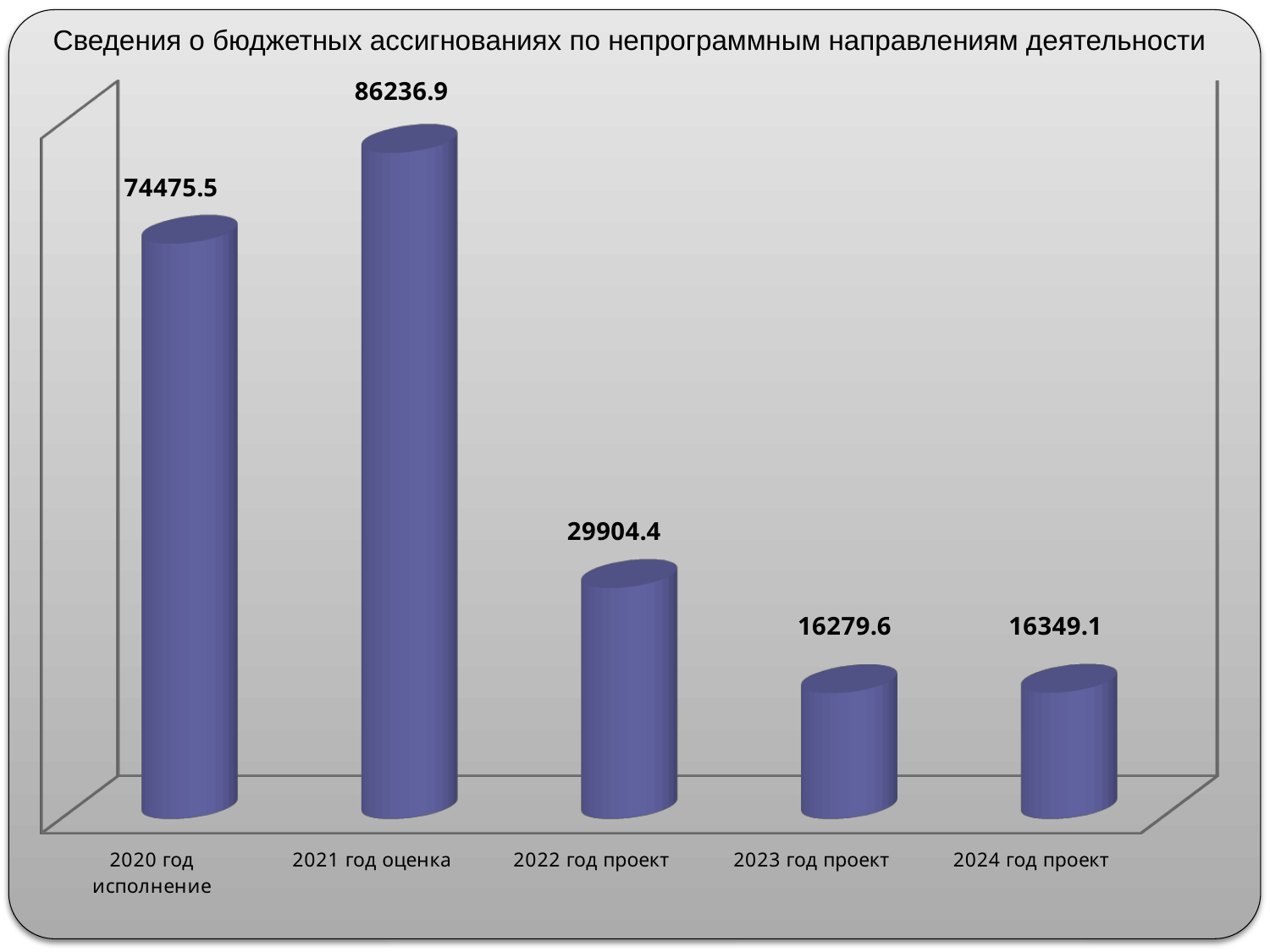
How many categories are shown on the x axis? 5 What is the title of the chart? Сведения о бюджетных ассигнованиях по непрограммным направлениям деятельности What is the value for 2024 год проект? 16349.1 What is the value for 2021 год оценка? 86236.9 Which is larger, the value for 2020 год исполнение or the value for 2022 год проект? 2020 год исполнение What is the value for 2022 год проект? 29904.4 What is the difference between the values for 2022 год проект and 2023 год проект? 13624.8 What is the difference between the values for 2021 год оценка and 2020 год исполнение? 11761.4 Which category has the highest value? 2021 год оценка Which category has the lowest value? 2023 год проект What is the value for 2020 год исполнение? 74475.5 What kind of chart is this? bar chart